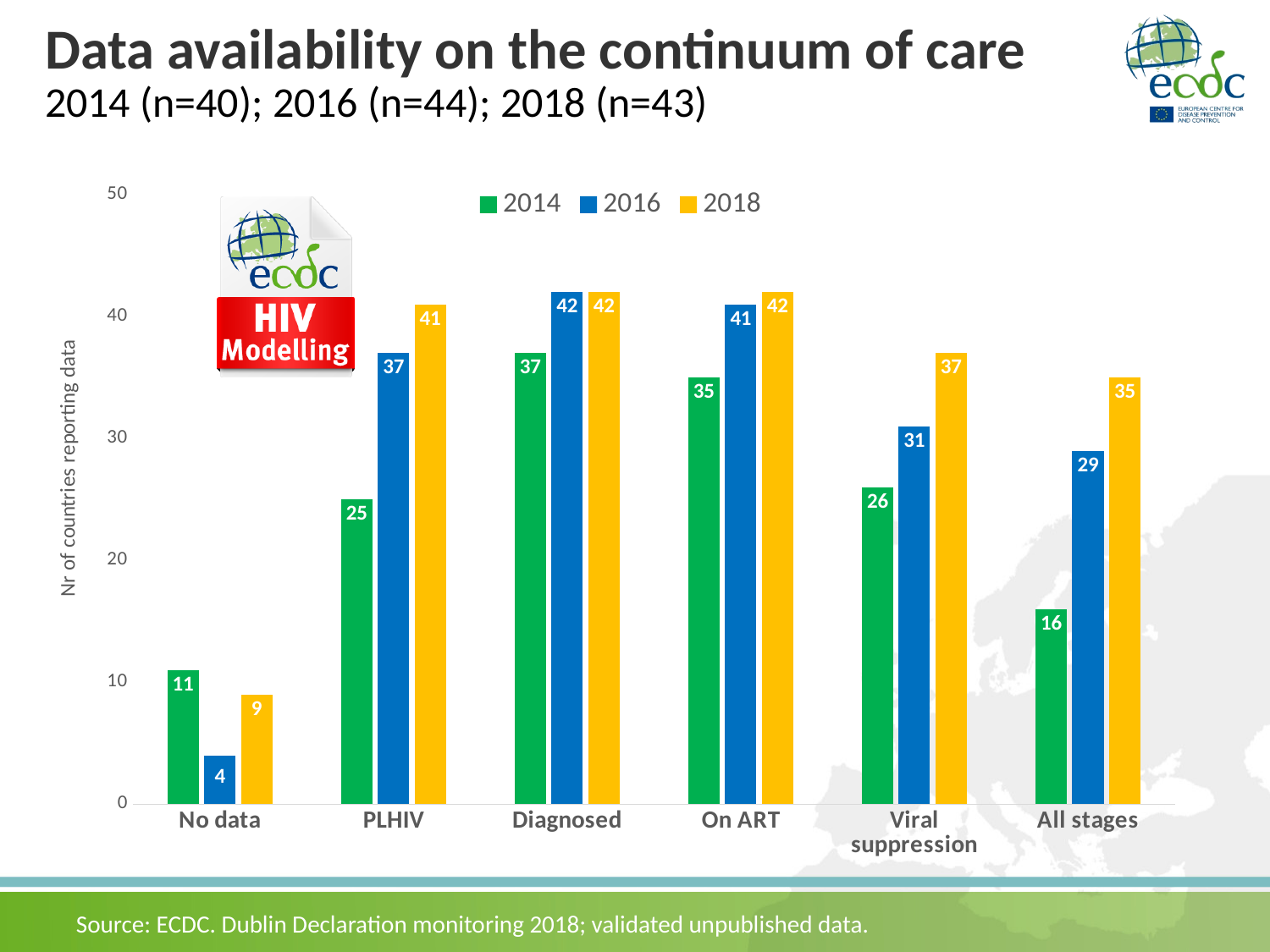
What is the value for 2018 in the Viral suppression category? 37 What is the difference between the 2018 and 2014 values in the All stages category? 19 What is the value for 2014 in the All stages category? 16 How many categories are shown on the x axis? 6 What is the label of the y axis? Nr of countries reporting data Do the values for the All stages category rise or fall from 2014 to 2018? Rise What is the value for 2016 in the PLHIV category? 37 Which category has the highest value for the 2014 series? Diagnosed Which is larger: the 2016 value for On ART or the 2016 value for Viral suppression? On ART How many series does the legend list? 3 Which category has the lowest value for the 2016 series? No data What kind of chart is shown on the slide? Bar chart